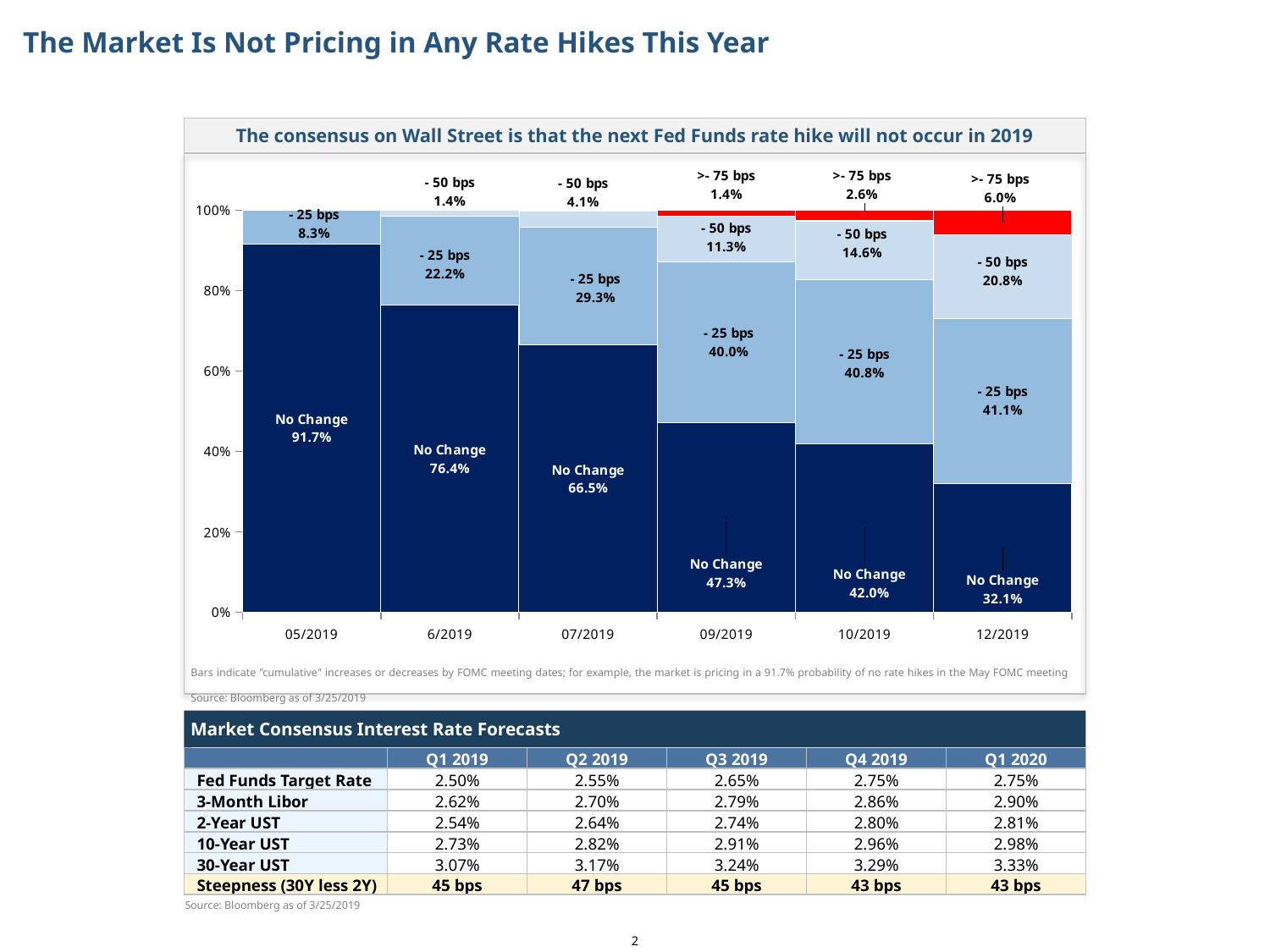
Which meeting date has the highest "No Change" probability? 05/2019 What is the difference between the "- 25 bps" probabilities for 6/2019 and 05/2019? 13.9 percentage points What is the "- 25 bps" probability shown for 12/2019? 41.1% What is the ">- 75 bps" probability shown for 12/2019? 6.0% What probability of "No Change" is shown for the 05/2019 FOMC meeting? 91.7% How many FOMC meeting dates are shown on the x axis of the chart? 6 Which meeting date has the lowest "No Change" probability? 12/2019 Does the "No Change" probability rise or fall from 05/2019 to 12/2019? Fall What kind of chart is used to show the rate-change probabilities? Stacked bar chart What is the "- 50 bps" probability shown for 10/2019? 14.6% Which has the larger "- 50 bps" probability, 07/2019 or 09/2019? 09/2019 By how many percentage points does the "No Change" probability for 05/2019 exceed that for 6/2019? 15.3 percentage points